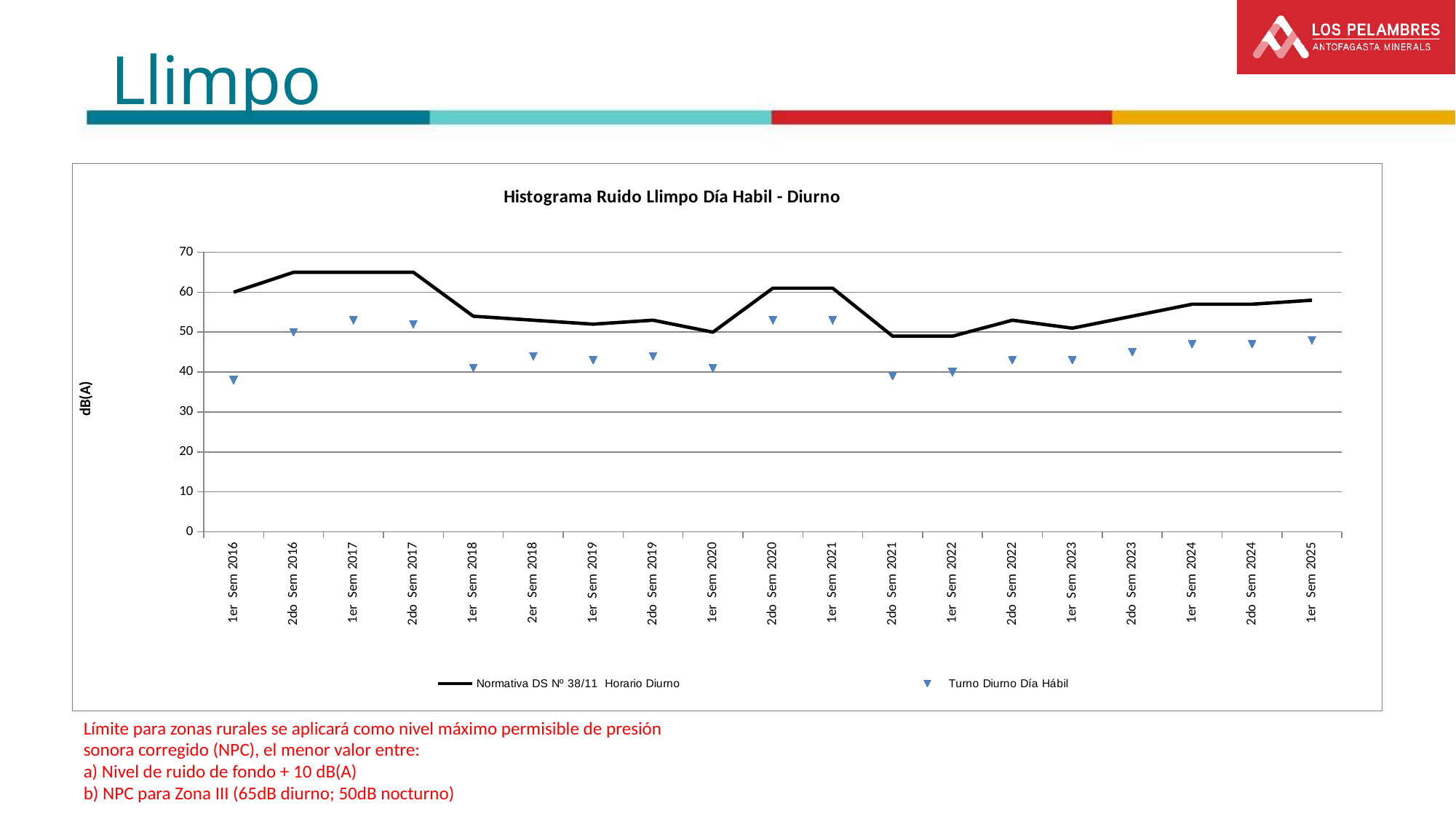
Is the value of Turno Diurno Día Hábil for 1er Sem 2016 greater or less than 40? less What is the title of the chart? Histograma Ruido Llimpo Día Habil - Diurno What is the label of the y axis? dB(A) Is the value of Turno Diurno Día Hábil for 1er Sem 2025 greater or less than 50? less What kind of chart is shown on the slide? line chart For 1er Sem 2016, which series has the larger value: Normativa DS Nº 38/11 Horario Diurno or Turno Diurno Día Hábil? Normativa DS Nº 38/11 Horario Diurno How many series does the chart legend list? 2 Do the Turno Diurno Día Hábil values rise or fall from 2do Sem 2022 to 1er Sem 2025? rise Is the value of Normativa DS Nº 38/11 Horario Diurno for 2do Sem 2016 greater or less than 60? greater How many semester categories are shown on the x axis? 19